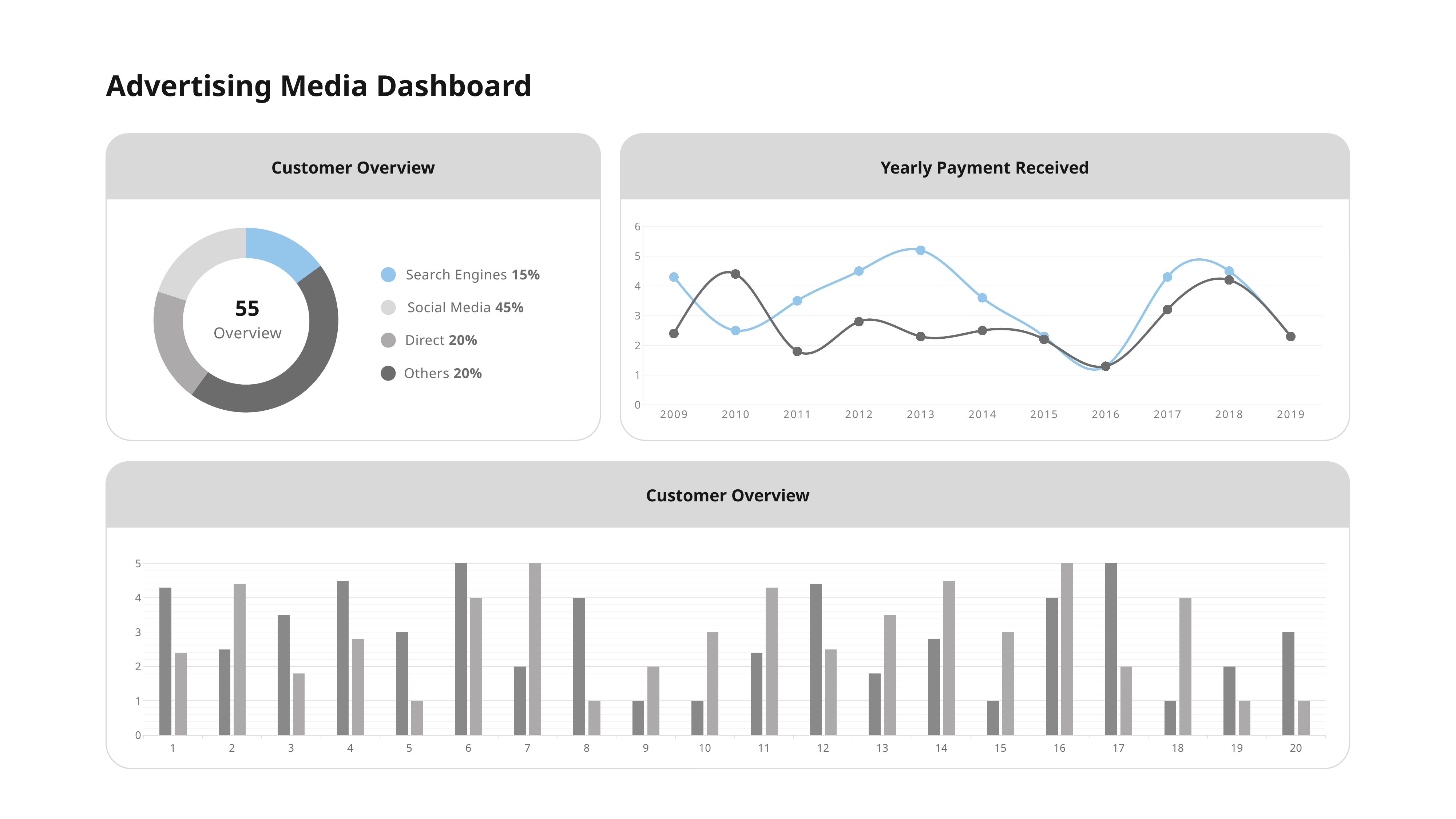
In the Yearly Payment Received chart, is the value of the dark grey line in 2011 greater or less than 2? less In the Customer Overview donut chart at the top left, what number is printed in the centre of the donut? 55 In the Customer Overview donut chart at the top left, which category has the smallest share? Search Engines In the Yearly Payment Received chart, which line has the higher value in 2010, the blue line or the dark grey line? the dark grey line In the Customer Overview chart at the bottom of the slide, is the dark grey bar for category 9 greater or less than 2? less What kind of chart is the Yearly Payment Received chart? line chart In the Yearly Payment Received chart, how many years are shown on the x axis? 11 In the Customer Overview chart at the bottom of the slide, how many categories are shown on the x axis? 20 In the Yearly Payment Received chart, is the value of the blue line in 2013 greater or less than 5? greater In the Customer Overview donut chart at the top left, what percentage is shown for Social Media? 45% In the Customer Overview donut chart at the top left, how many percentage points larger is Social Media than Search Engines? 30%